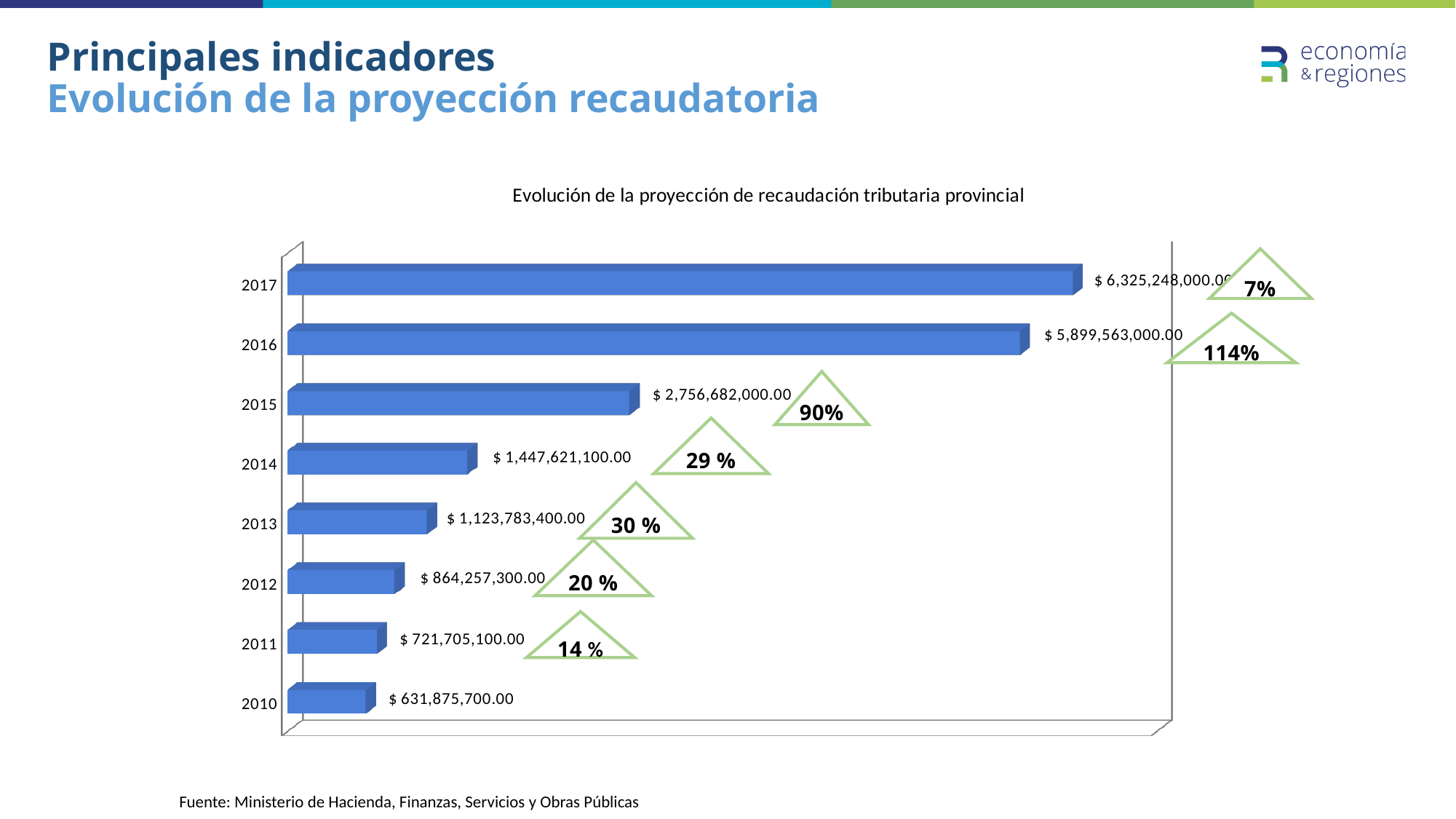
What is the difference between the values for 2011 and 2010? $ 89,829,400.00 What is the value for 2013? $ 1,123,783,400.00 What is the difference between the values for 2016 and 2015? $ 3,142,881,000.00 How many years are shown in the chart? 8 Which year has the highest value? 2017 What is the value for 2015? $ 2,756,682,000.00 Which year has the lowest value? 2010 What is the value for 2016? $ 5,899,563,000.00 What is the value for 2010? $ 631,875,700.00 Do the values rise or fall from 2010 to 2017? Rise What kind of chart is shown on the slide? Bar chart Which is larger, the value for 2014 or the value for 2013? 2014